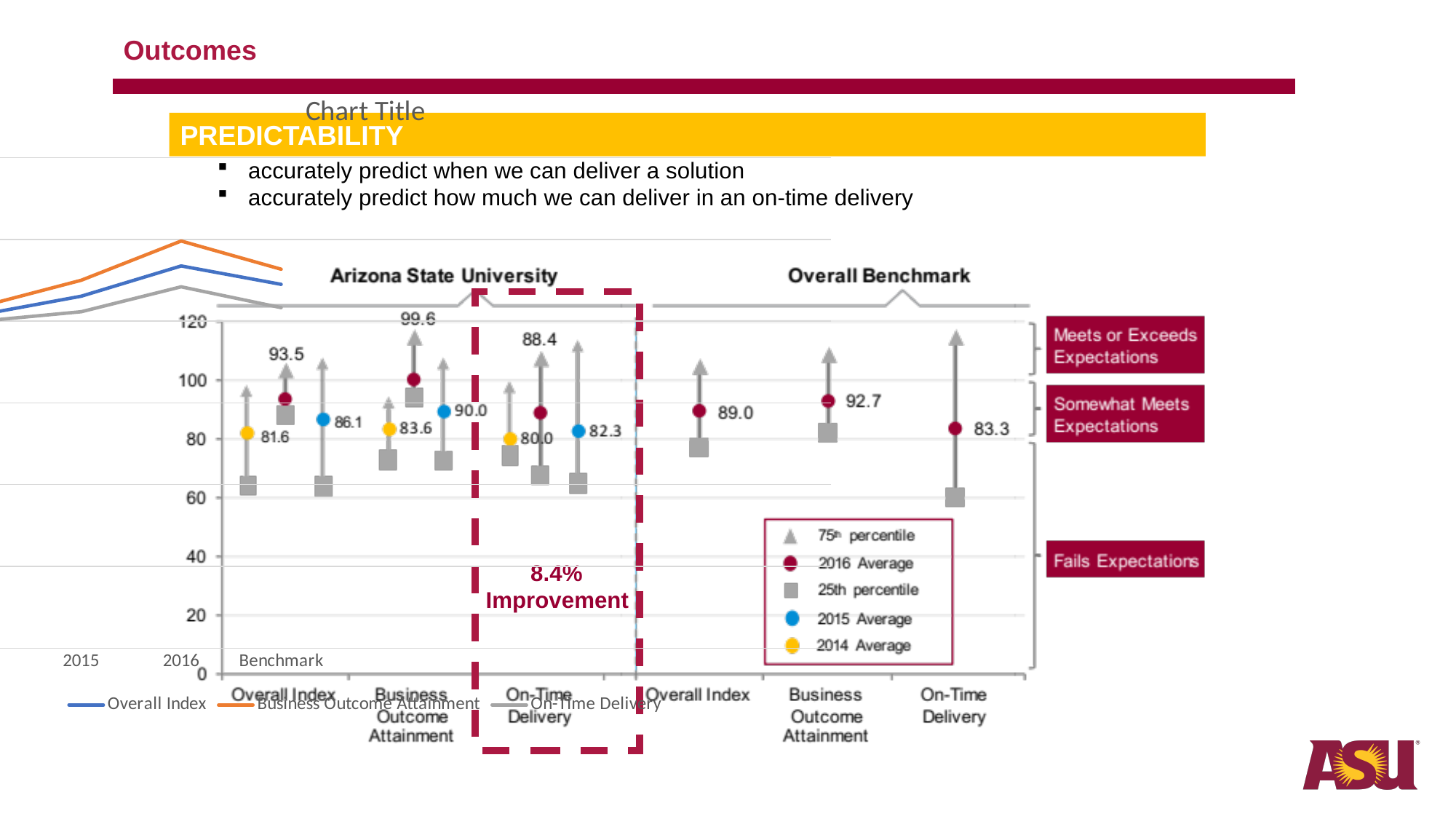
In the dot chart, is the Arizona State University 2015 Average for Overall Index greater or less than 80? greater In the Arizona State University section of the dot chart, which category has the lowest 2014 Average? On-Time Delivery In the dot chart, what is the difference between the Arizona State University 2016 Average for On-Time Delivery (88.4) and the 2014 Average for On-Time Delivery (80.0)? 8.4 In the Arizona State University section of the dot chart, what is the 2014 Average for On-Time Delivery? 80.0 In the Overall Benchmark section of the dot chart, what is the 2016 Average for On-Time Delivery? 83.3 In the Arizona State University section of the dot chart, what is the 2016 Average for Overall Index? 93.5 In the dot chart, which is larger: the Arizona State University 2016 Average for Overall Index or the Overall Benchmark 2016 Average for Overall Index? Arizona State University (93.5) How many entries does the legend of the dot chart list? 5 What improvement percentage is highlighted in the dashed box on the dot chart? 8.4% In the Arizona State University section of the dot chart, which category has the highest 2016 Average? Business Outcome Attainment In the Arizona State University section of the dot chart, what is the 2015 Average for Business Outcome Attainment? 90.0 In the Overall Benchmark section of the dot chart, what is the 2016 Average for Business Outcome Attainment? 92.7